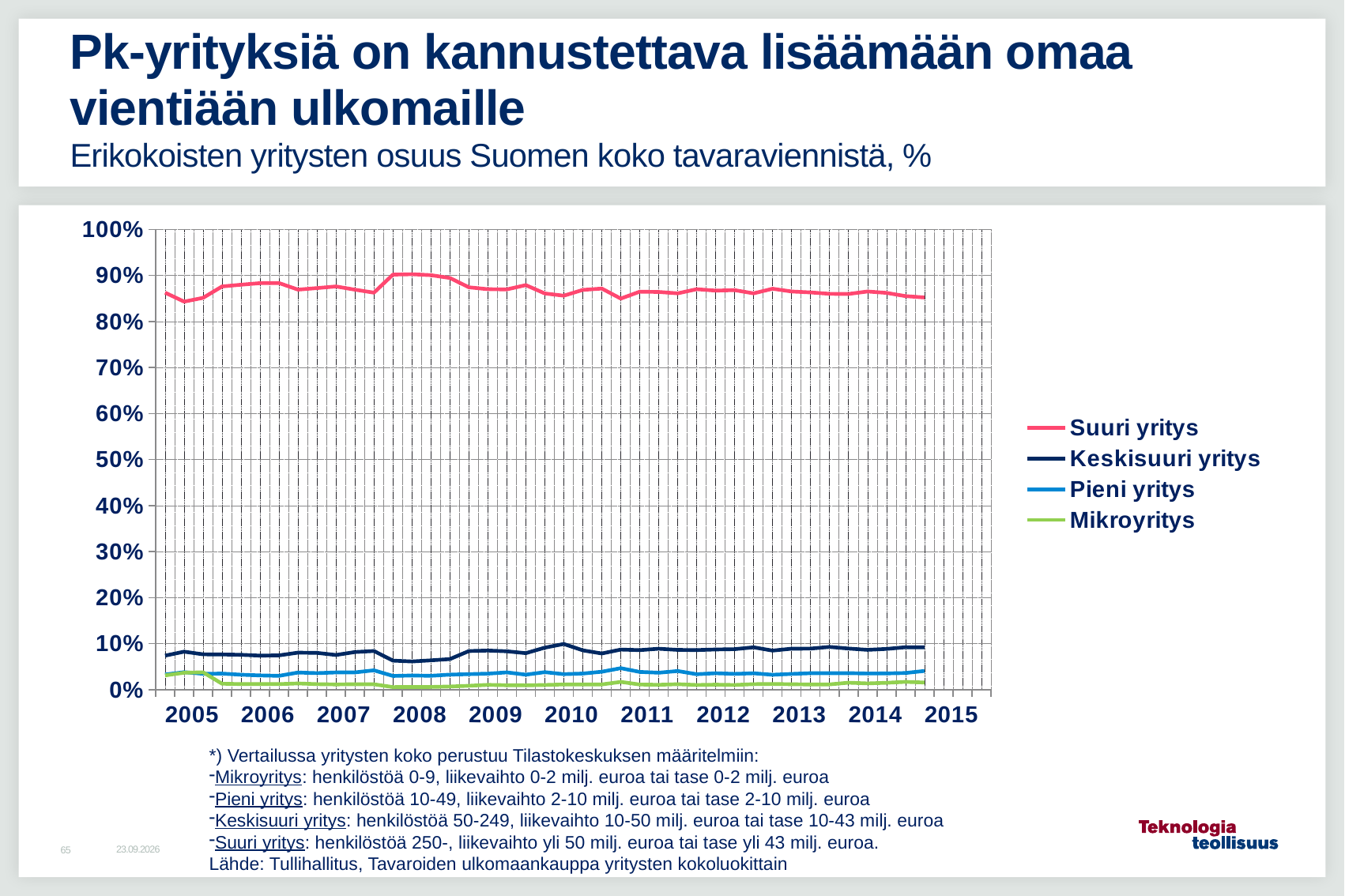
Is the value for Keskisuuri yritys in 2010 greater or less than 20%? less What colour is the line for Suuri yritys? red Is the value for Pieni yritys in 2013 greater or less than 10%? less What kind of chart is shown on the slide? line chart What are the four series listed in the legend? Suuri yritys, Keskisuuri yritys, Pieni yritys, Mikroyritys How many series does the legend list? 4 Which series has the highest share of exports throughout the period? Suuri yritys Is the value for Suuri yritys in 2005 greater or less than 90%? less In 2010, which is larger: the value for Keskisuuri yritys or the value for Pieni yritys? Keskisuuri yritys How many years are labelled on the x axis? 11